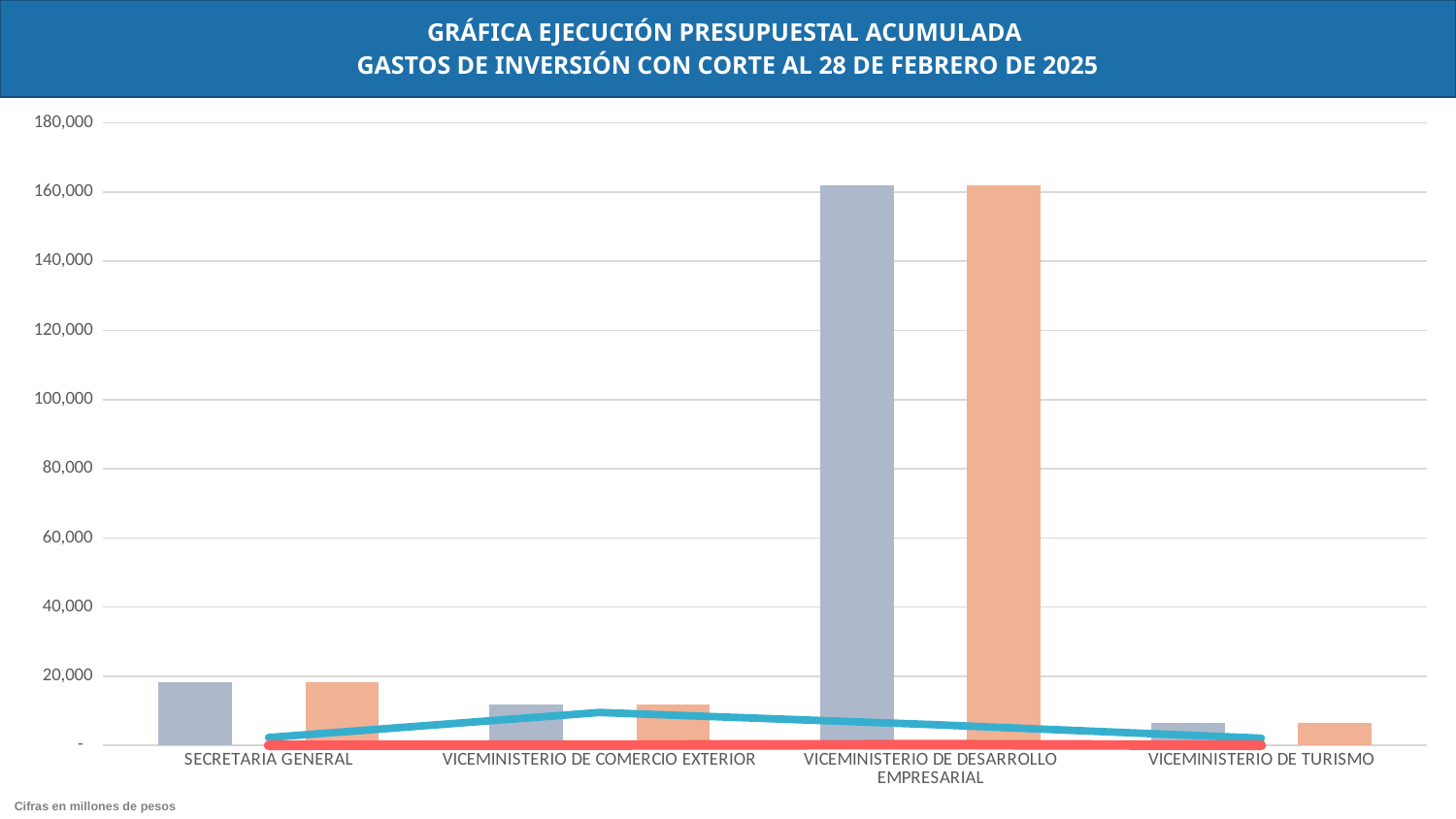
Which has taller bars, SECRETARIA GENERAL or VICEMINISTERIO DE COMERCIO EXTERIOR? SECRETARIA GENERAL Is the value of the bars for VICEMINISTERIO DE COMERCIO EXTERIOR greater or less than 20,000? less How many categories are shown on the x axis of the chart? 4 What is the highest value shown on the vertical axis of the chart? 180,000 According to the note below the chart, in what units are the figures expressed? Cifras en millones de pesos Is the value of the bars for VICEMINISTERIO DE TURISMO greater or less than 20,000? less Which category has the shortest bars in the chart? VICEMINISTERIO DE TURISMO Is the value of the bars for VICEMINISTERIO DE DESARROLLO EMPRESARIAL greater or less than 140,000? greater Which category has the tallest bars in the chart? VICEMINISTERIO DE DESARROLLO EMPRESARIAL What kind of chart is shown on the slide? combination bar and line chart Which has taller bars, VICEMINISTERIO DE COMERCIO EXTERIOR or VICEMINISTERIO DE TURISMO? VICEMINISTERIO DE COMERCIO EXTERIOR